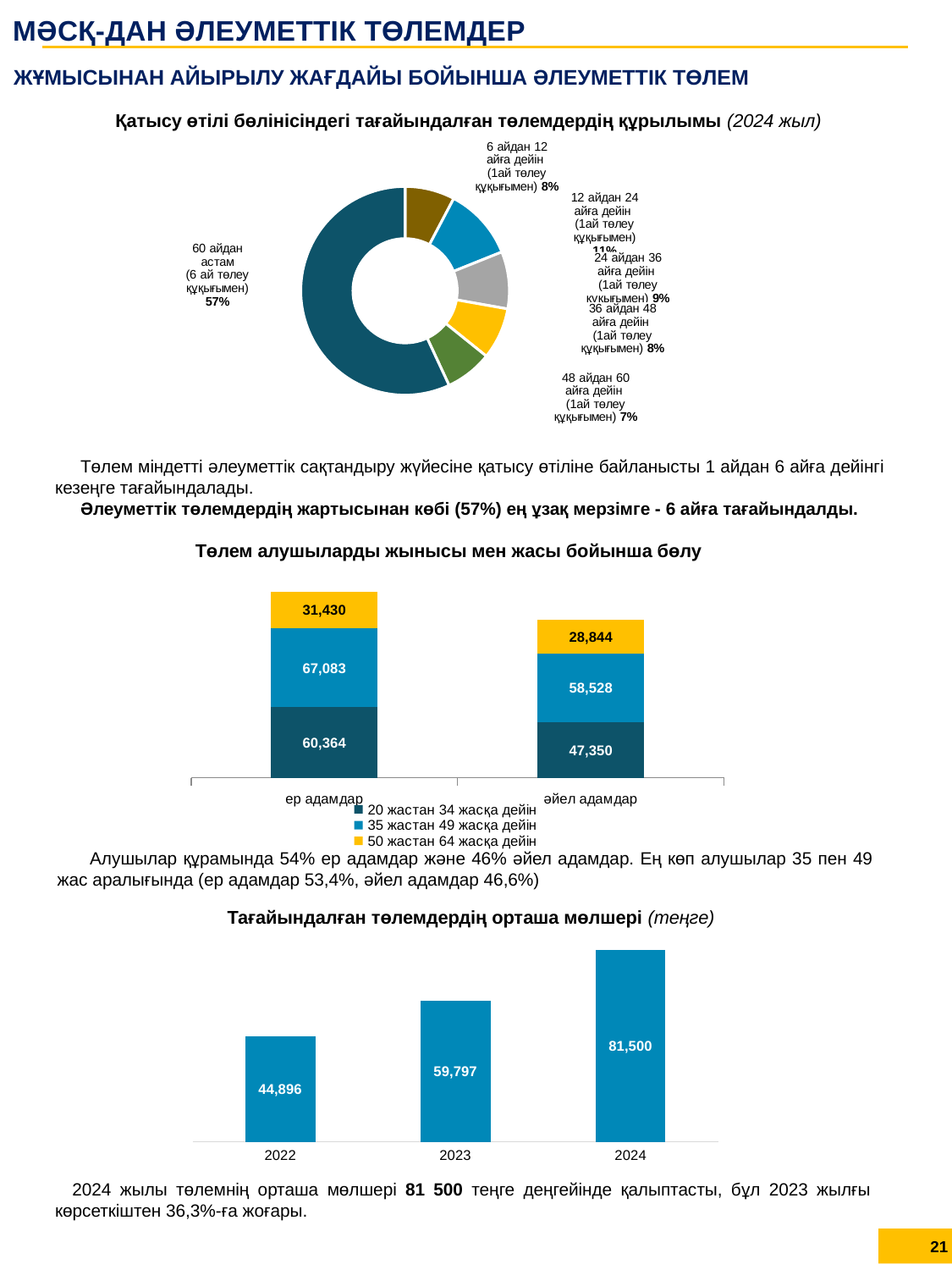
In the chart 'Төлем алушыларды жынысы мен жасы бойынша бөлу', how many series does the legend list? 3 What kind of chart is 'Қатысу өтілі бөлінісіндегі тағайындалған төлемдердің құрылымы (2024 жыл)'? Donut (pie) chart In the chart 'Тағайындалған төлемдердің орташа мөлшері (теңге)', what is the value for 2023? 59,797 In the chart 'Қатысу өтілі бөлінісіндегі тағайындалған төлемдердің құрылымы (2024 жыл)', what share is shown for '60 айдан астам (6 ай төлеу құқығымен)'? 57% In the chart 'Төлем алушыларды жынысы мен жасы бойынша бөлу', what is the difference between the '20 жастан 34 жасқа дейін' values for 'ер адамдар' and 'әйел адамдар'? 13,014 In the chart 'Қатысу өтілі бөлінісіндегі тағайындалған төлемдердің құрылымы (2024 жыл)', which category has the smallest share? 48 айдан 60 айға дейін (1ай төлеу құқығымен) In the chart 'Төлем алушыларды жынысы мен жасы бойынша бөлу', what is the total of the stacked bar for 'ер адамдар'? 158,877 In the chart 'Төлем алушыларды жынысы мен жасы бойынша бөлу', what is the value for '35 жастан 49 жасқа дейін' for 'ер адамдар'? 67,083 In the chart 'Қатысу өтілі бөлінісіндегі тағайындалған төлемдердің құрылымы (2024 жыл)', which category has the largest share? 60 айдан астам (6 ай төлеу құқығымен) In the chart 'Тағайындалған төлемдердің орташа мөлшері (теңге)', do the values rise or fall from 2022 to 2024? Rise In the chart 'Төлем алушыларды жынысы мен жасы бойынша бөлу', what is the value for '50 жастан 64 жасқа дейін' for 'әйел адамдар'? 28,844 In the chart 'Қатысу өтілі бөлінісіндегі тағайындалған төлемдердің құрылымы (2024 жыл)', what share is shown for '48 айдан 60 айға дейін (1ай төлеу құқығымен)'? 7%